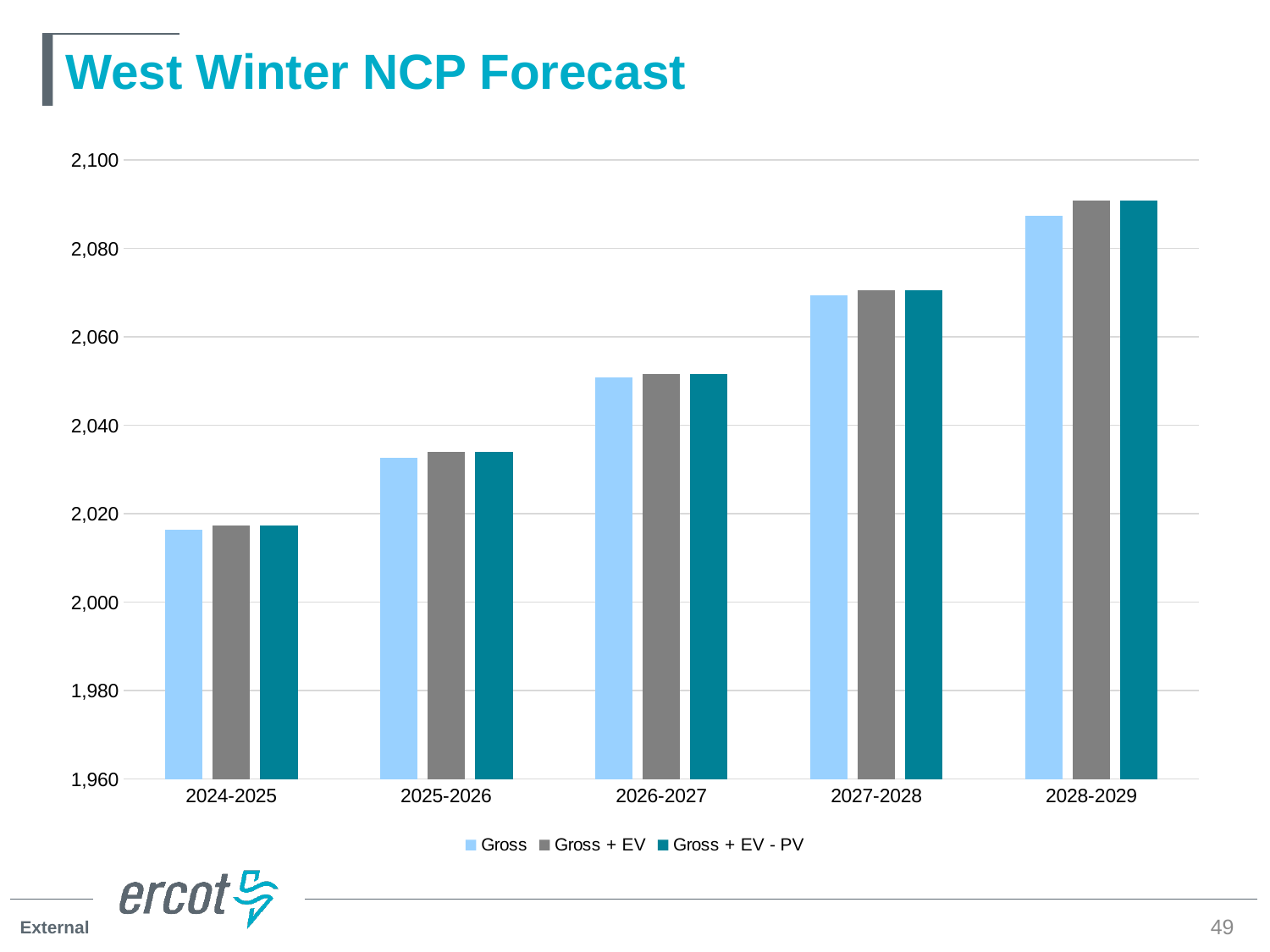
Is the Gross value for 2028-2029 greater or less than 2,080? greater What is the title of the chart? West Winter NCP Forecast Do the Gross values rise or fall from 2024-2025 to 2028-2029? Rise How many winter seasons are shown on the x axis? 5 Which winter season has the lowest Gross + EV value? 2024-2025 Is the Gross + EV - PV value for 2025-2026 greater or less than 2,040? less Which is larger, the Gross value for 2028-2029 or the Gross value for 2024-2025? 2028-2029 Is the Gross value for 2024-2025 greater or less than 2,020? less What kind of chart is shown on the slide? Bar chart Which winter season has the highest Gross value? 2028-2029 How many series does the legend list? 3